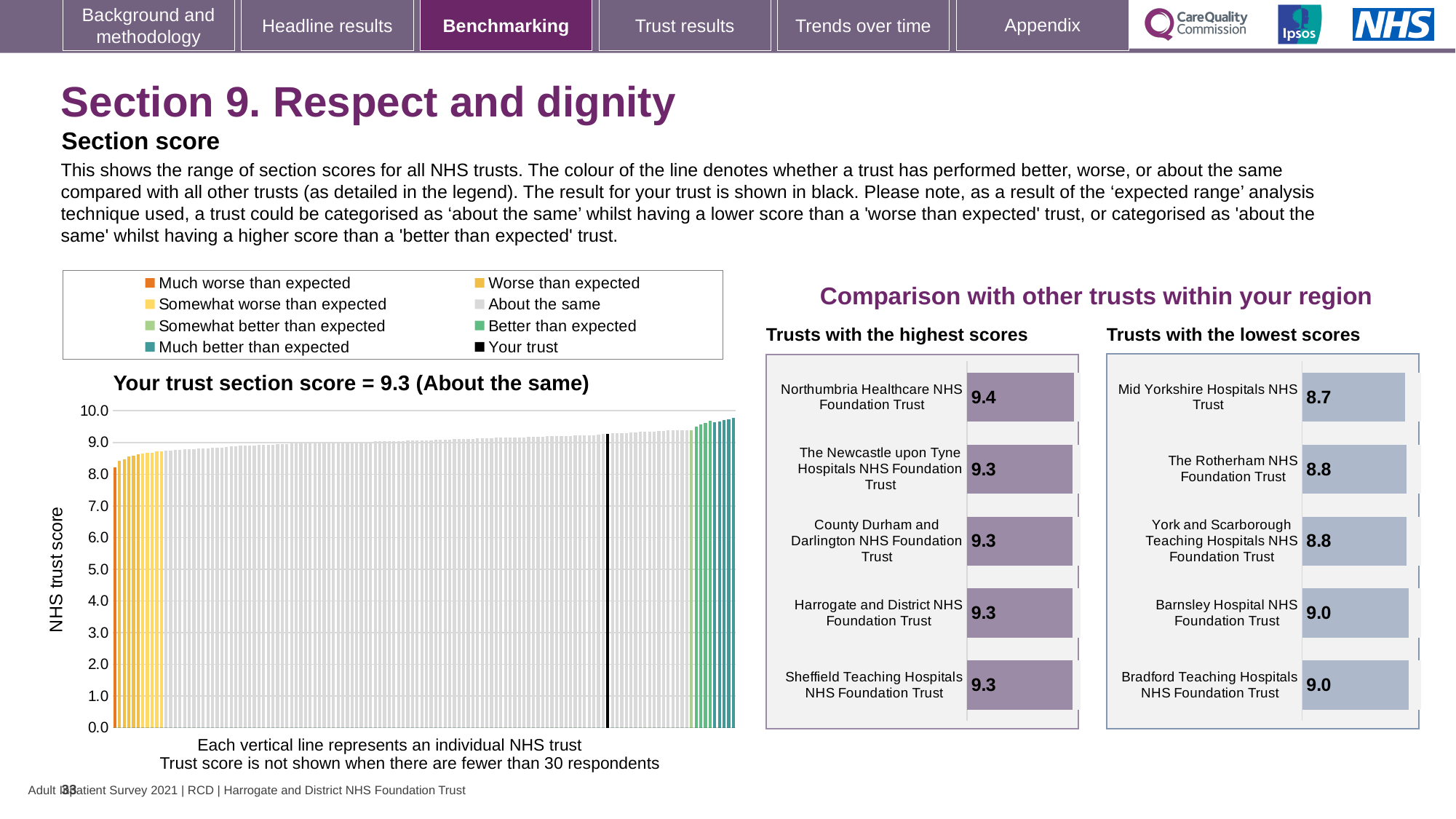
What kind of chart is the 'Your trust section score' chart on the left? Bar chart In the 'Trusts with the lowest scores' chart, which trust has the lowest score? Mid Yorkshire Hospitals NHS Trust In the 'Trusts with the lowest scores' chart, what is the score for Mid Yorkshire Hospitals NHS Trust? 8.7 In the 'Your trust section score' chart, do the bar heights rise or fall from left to right? Rise In the 'Your trust section score' chart, is the value of the leftmost bar greater or less than 8.0? greater In the 'Trusts with the lowest scores' chart, what is the difference between the scores of Bradford Teaching Hospitals NHS Foundation Trust and Mid Yorkshire Hospitals NHS Trust? 0.3 In the 'Trusts with the highest scores' chart, which trust has the highest score? Northumbria Healthcare NHS Foundation Trust According to the title of the left chart, what is your trust's section score? 9.3 (About the same) In the 'Trusts with the highest scores' chart, what is the score for Northumbria Healthcare NHS Foundation Trust? 9.4 How many entries does the legend above the 'Your trust section score' chart list? 8 How many trusts are listed in the 'Trusts with the highest scores' chart? 5 In the 'Trusts with the lowest scores' chart, which has the larger score: Barnsley Hospital NHS Foundation Trust or The Rotherham NHS Foundation Trust? Barnsley Hospital NHS Foundation Trust